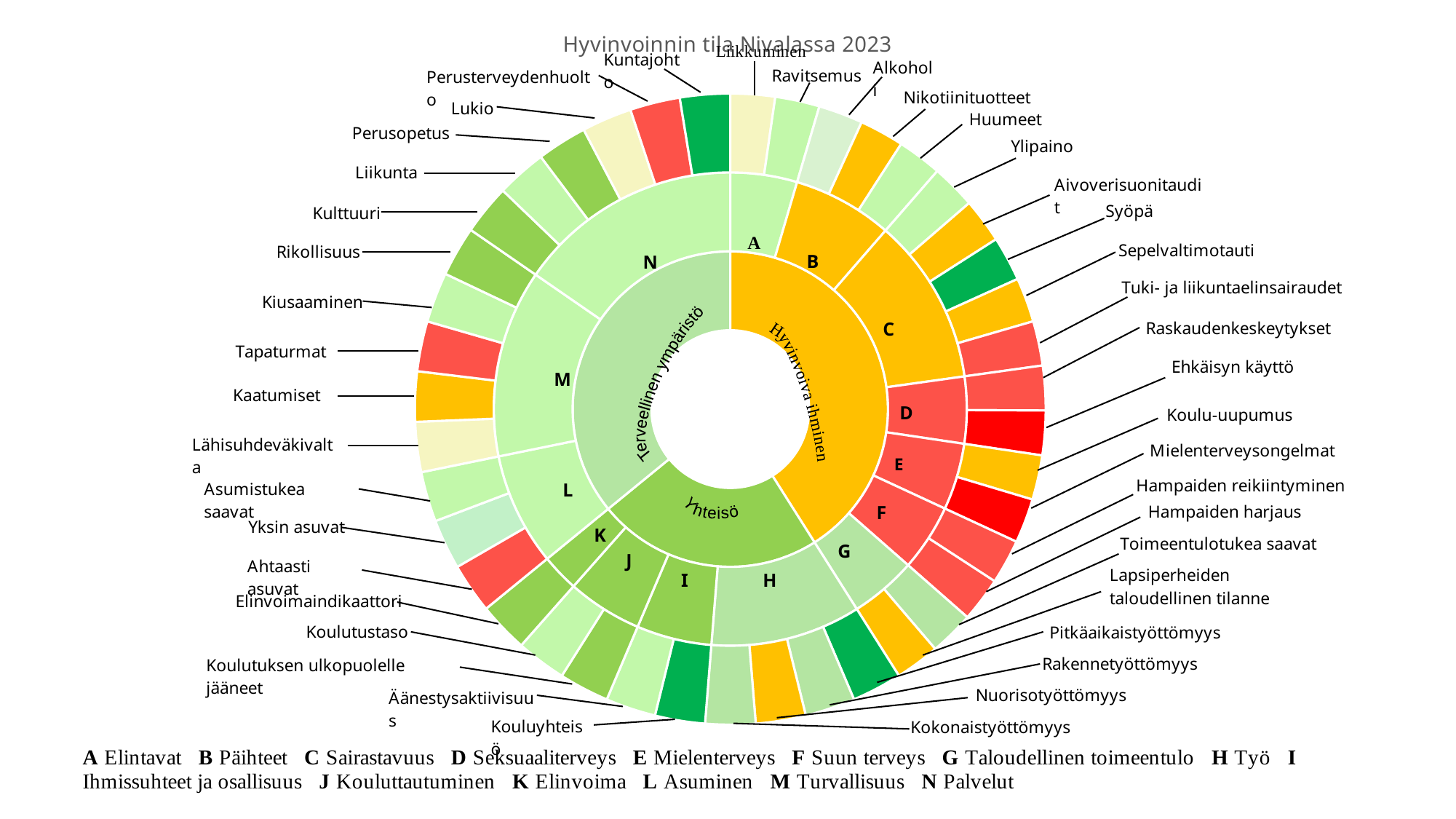
How many outer-ring segments belong to category D (Seksuaaliterveys)? 2 According to the legend, which letter stands for Työ? H How many lettered categories (A to N) are in the middle ring of the chart? 14 What kind of chart is shown on the slide? sunburst chart What is the title of the chart? Hyvinvoinnin tila Nivalassa 2023 How many outer-ring segments belong to category B (Päihteet)? 3 Which innermost ring segment covers the largest share of the chart? Hyvinvoiva ihminen